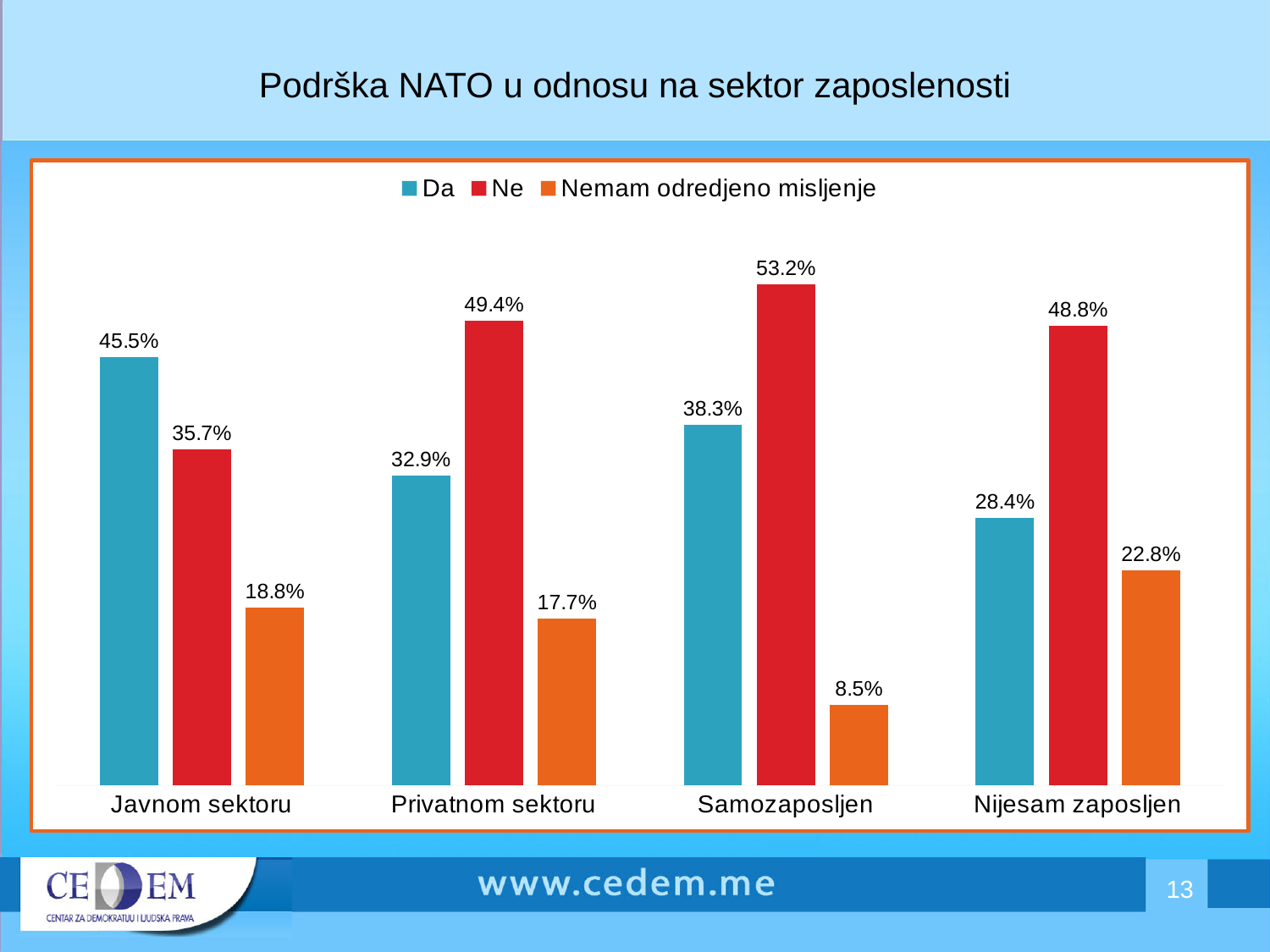
What kind of chart is shown on the slide? Bar chart What is the value for "Ne" in the Samozaposljen category? 53.2% How many series does the legend list? 3 Which category has the lowest value for the "Nemam odredjeno misljenje" series? Samozaposljen What is the difference between the "Ne" and "Da" values in the Privatnom sektoru category? 16.5% Which is larger in the Javnom sektoru category, the "Da" value or the "Ne" value? Da What is the value for "Da" in the Javnom sektoru category? 45.5% Which category has the highest value for the "Ne" series? Samozaposljen What is the title of the slide? Podrška NATO u odnosu na sektor zaposlenosti How many categories are shown on the x axis? 4 What is the value for "Nemam odredjeno misljenje" in the Nijesam zaposljen category? 22.8% Which colour represents the "Ne" series in the legend? Red